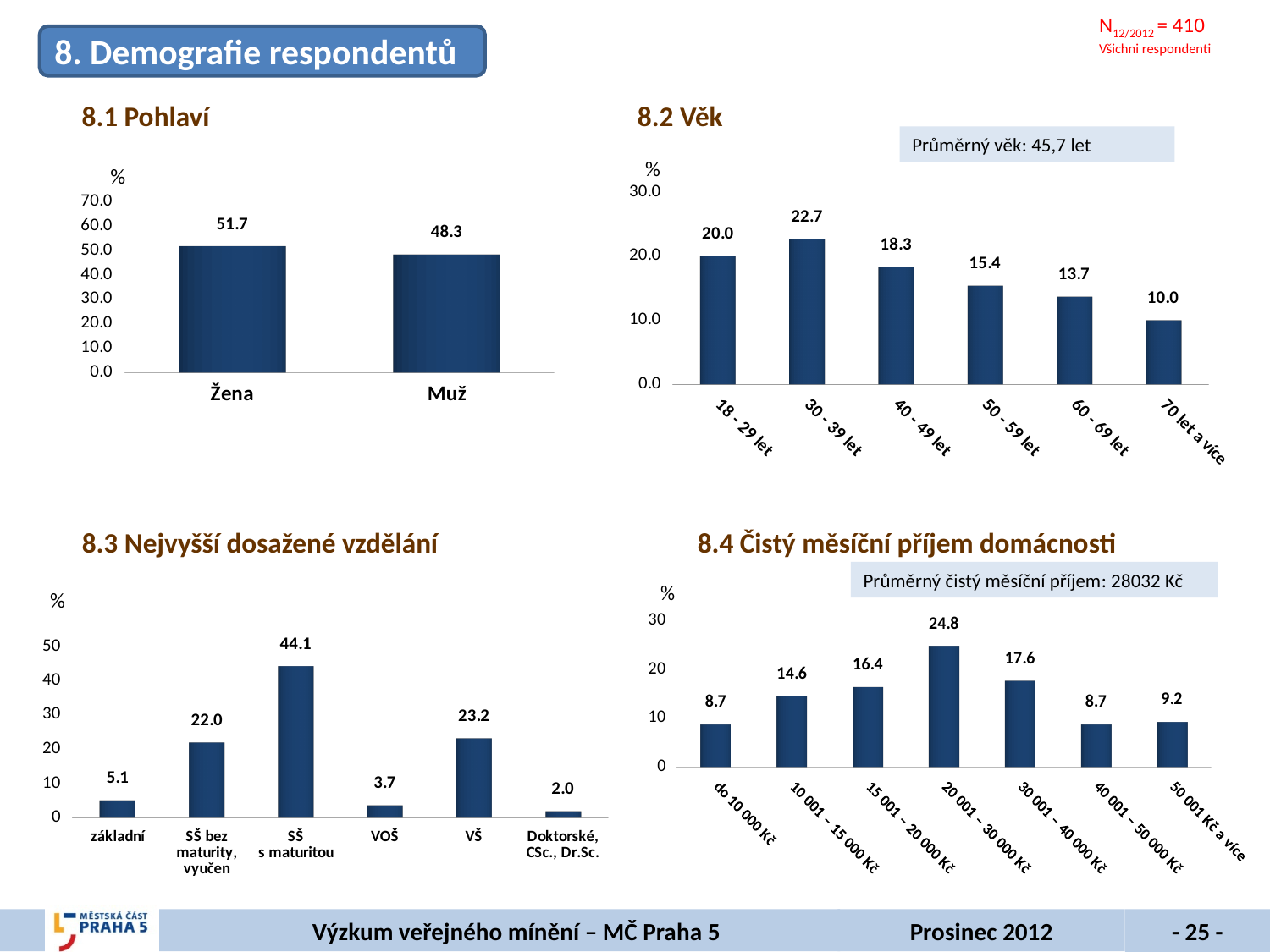
In the '8.2 Věk' chart, which age category has the highest value? 30 - 39 let In the '8.4 Čistý měsíční příjem domácnosti' chart, what is the value for 20 001 - 30 000 Kč? 24.8 In the '8.2 Věk' chart, what is the value for 50 - 59 let? 15.4 In the '8.1 Pohlaví' chart, what is the value for Žena? 51.7 In the '8.4 Čistý měsíční příjem domácnosti' chart, what is the difference between the values for 30 001 - 40 000 Kč and 15 001 - 20 000 Kč? 1.2 In the '8.2 Věk' chart, how many age categories are shown? 6 In the '8.3 Nejvyšší dosažené vzdělání' chart, what is the value for VŠ? 23.2 In the '8.3 Nejvyšší dosažené vzdělání' chart, which is larger: the value for základní or the value for VOŠ? základní In the '8.1 Pohlaví' chart, what is the difference between the values for Žena and Muž? 3.4 What kind of chart is the '8.4 Čistý měsíční příjem domácnosti' chart? bar chart In the '8.3 Nejvyšší dosažené vzdělání' chart, which category has the lowest value? Doktorské, CSc., Dr.Sc. In the '8.2 Věk' chart, do the values rise or fall from 30 - 39 let to 70 let a více? fall